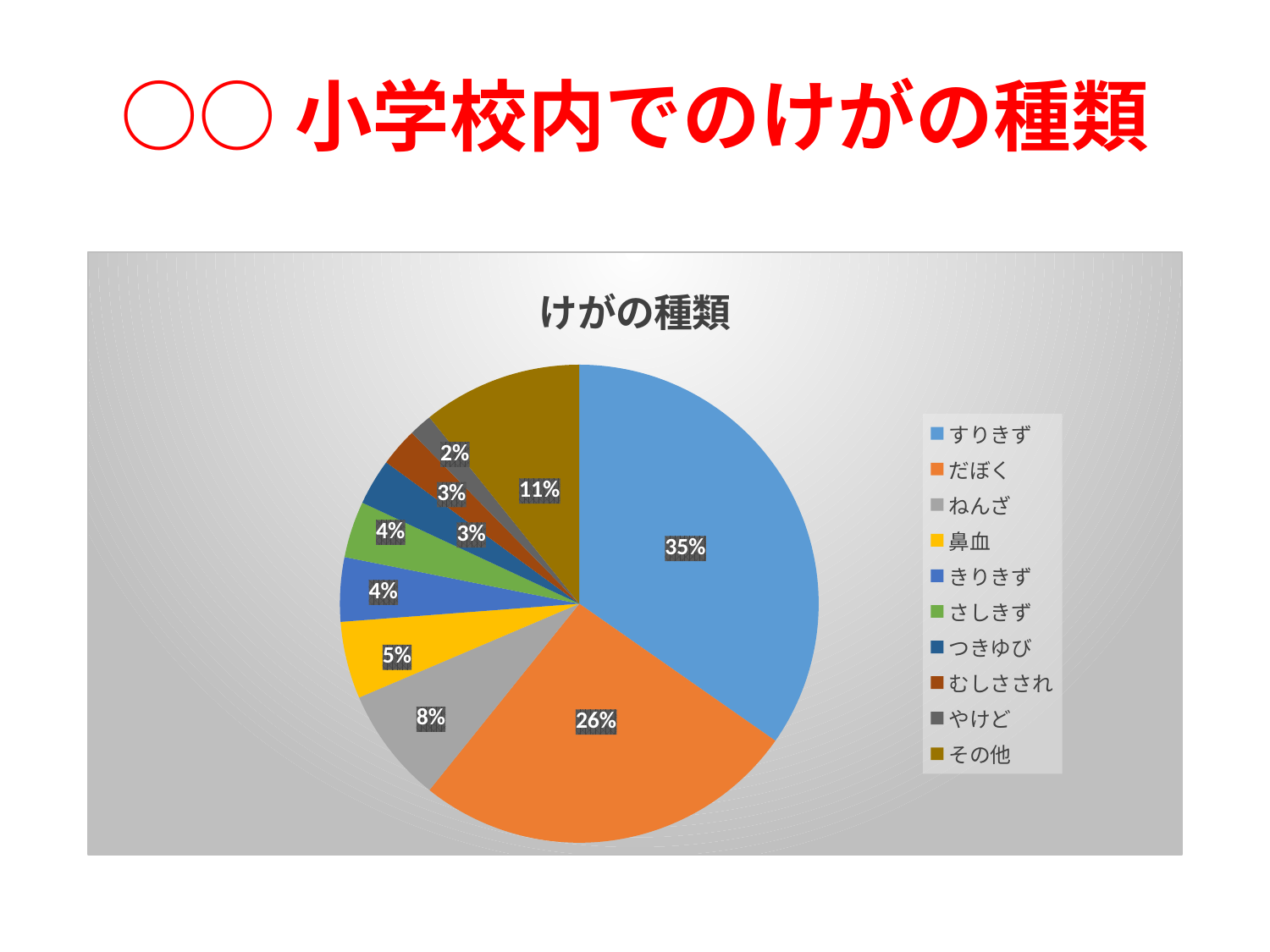
Which category has the smallest slice of the pie? やけど What is the difference in percentage points between すりきず and だぼく? 9 What is the value shown for つきゆび? 3% What is the title of the chart? けがの種類 Which category has the largest slice of the pie? すりきず What kind of chart is shown on the slide? pie chart How many categories does the legend list? 10 What share of the pie is その他? 11% Which is larger, the slice for 鼻血 or the slice for ねんざ? ねんざ What is the value shown for だぼく? 26% What percentage of the pie does すりきず account for? 35% What is the value shown for ねんざ? 8%